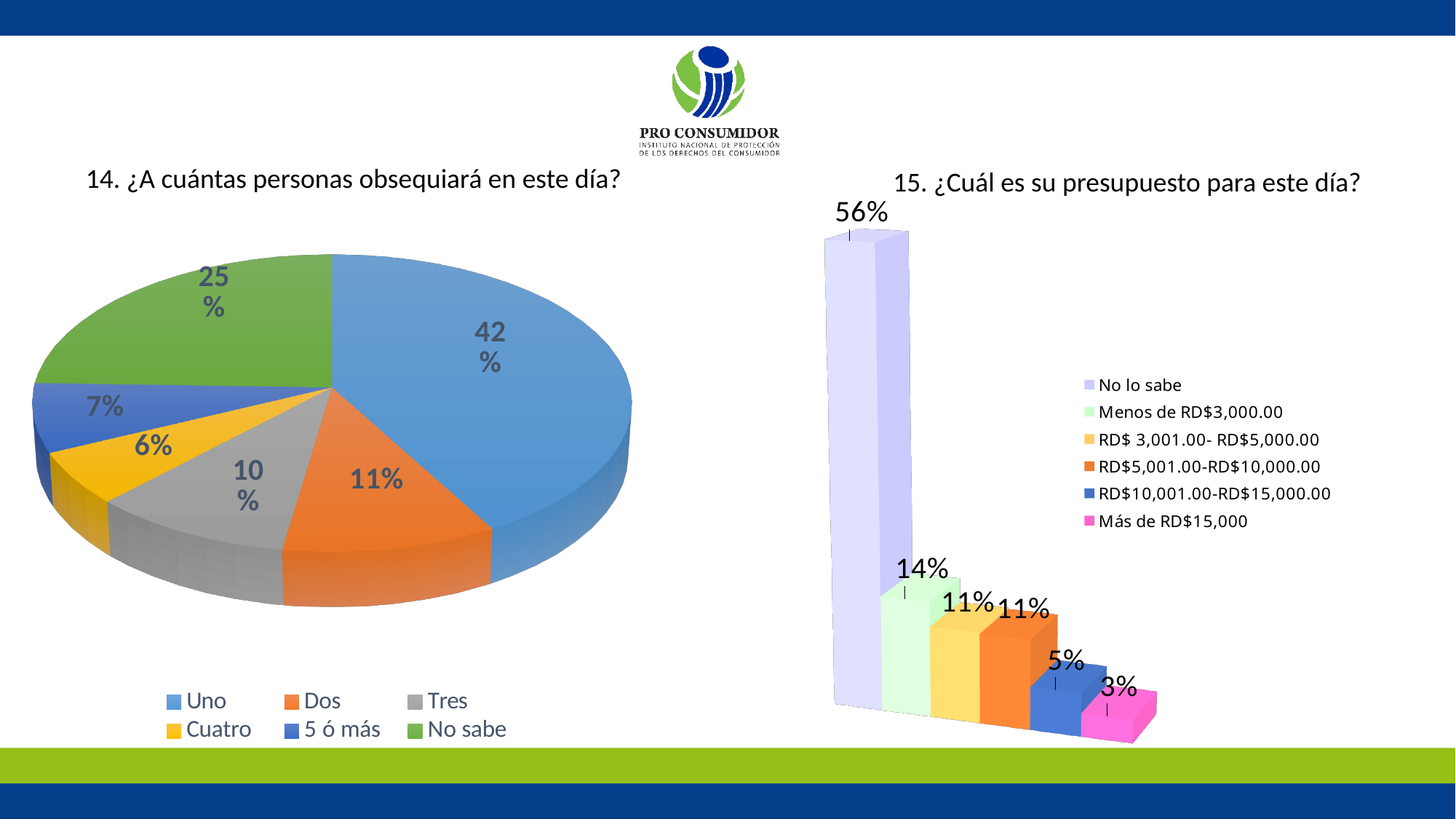
In the chart titled "14. ¿A cuántas personas obsequiará en este día?", which category has the smallest slice? Cuatro What type of chart is the one titled "14. ¿A cuántas personas obsequiará en este día?"? Pie chart In the chart titled "14. ¿A cuántas personas obsequiará en este día?", what percentage is shown for "Uno"? 42% In the chart titled "15. ¿Cuál es su presupuesto para este día?", what is the difference between "No lo sabe" and "Menos de RD$3,000.00"? 42% In the chart titled "15. ¿Cuál es su presupuesto para este día?", which category has the highest value? No lo sabe In the chart titled "14. ¿A cuántas personas obsequiará en este día?", what percentage is shown for "No sabe"? 25% In the chart titled "14. ¿A cuántas personas obsequiará en este día?", what is the difference between the "Uno" and "Dos" percentages? 31% In the chart titled "15. ¿Cuál es su presupuesto para este día?", what percentage is shown for "No lo sabe"? 56% In the chart titled "15. ¿Cuál es su presupuesto para este día?", which is larger: "Menos de RD$3,000.00" or "RD$10,001.00-RD$15,000.00"? Menos de RD$3,000.00 What type of chart is the one titled "15. ¿Cuál es su presupuesto para este día?"? Bar chart In the chart titled "15. ¿Cuál es su presupuesto para este día?", what percentage is shown for "Más de RD$15,000"? 3% In the chart titled "14. ¿A cuántas personas obsequiará en este día?", how many categories does the legend list? 6